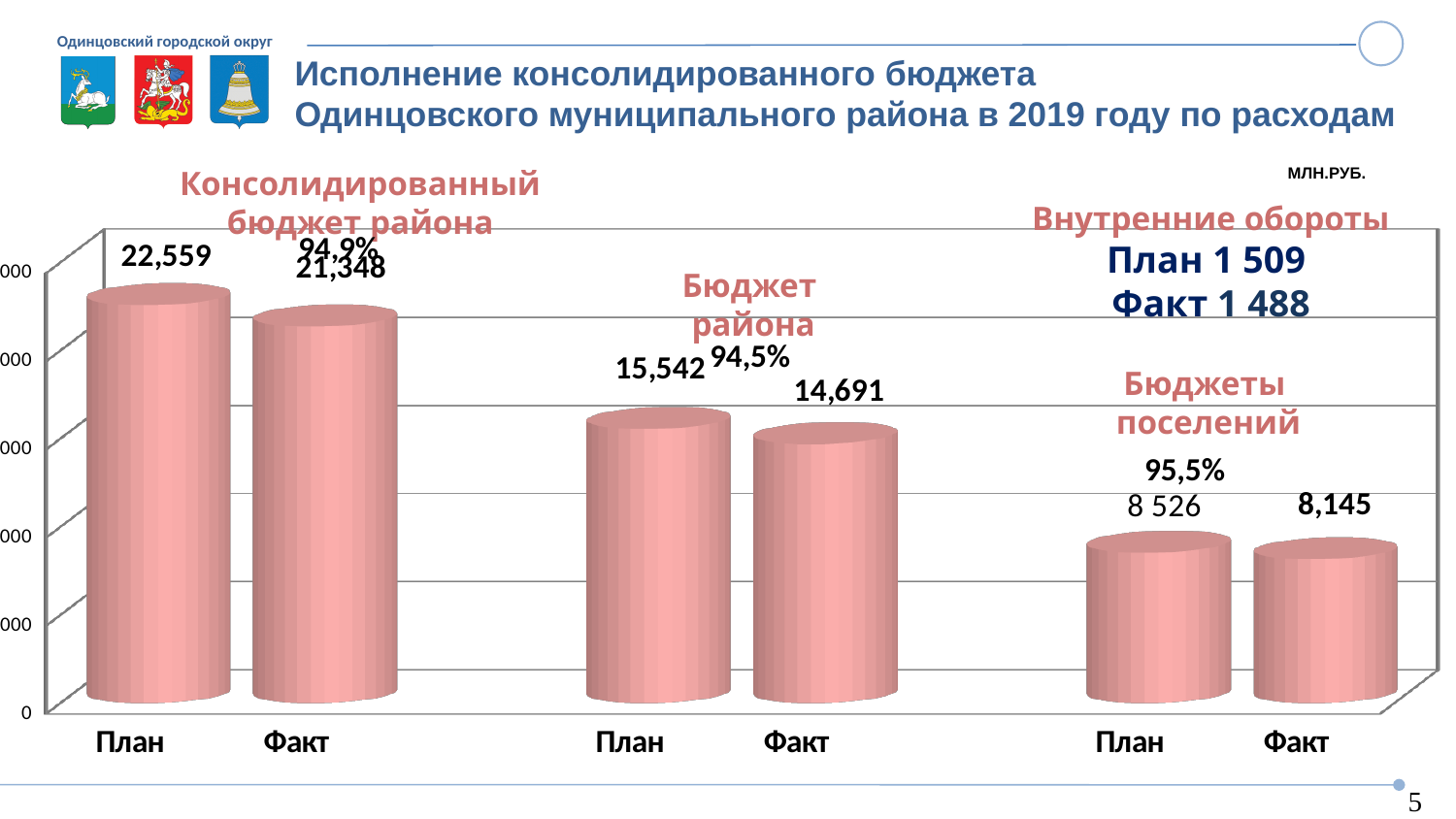
How many bars are plotted on the chart? 6 What is the Факт value for Бюджет района? 14,691 What is the План value for Бюджет района? 15,542 What is the difference between the План and Факт values for Бюджет района? 851 What is the Факт value for Консолидированный бюджет района? 21,348 Which bar is the lowest on the chart? Факт for Бюджеты поселений Which bar is the tallest on the chart? План for Консолидированный бюджет района What type of chart is shown on the slide? Bar chart What is the Факт value for Бюджеты поселений? 8,145 What is the План value for Консолидированный бюджет района? 22,559 Which is larger for Консолидированный бюджет района, План or Факт? План What percentage is shown for Бюджеты поселений? 95,5%